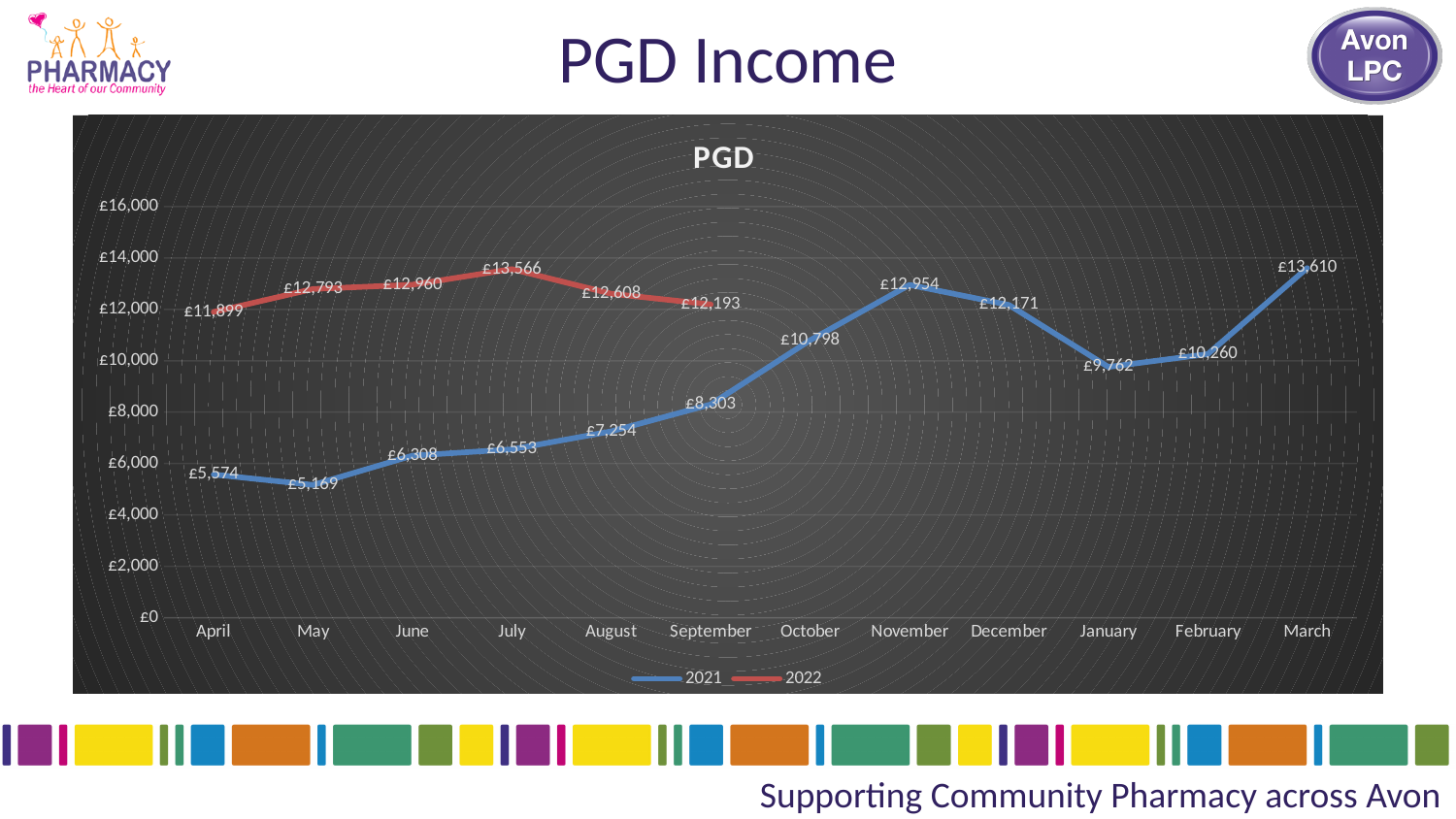
What kind of chart is this? Line chart Does the 2021 line rise or fall from April to September? Rise Which month has the highest 2021 value? March What is the 2022 value for July? £13,566 How many series does the legend list? 2 What is the 2021 value for November? £12,954 Which is larger in June, the 2021 value or the 2022 value? 2022 What is the difference between the 2022 and 2021 values for April? £6,325 Which month has the lowest 2021 value? May How many months are shown on the x axis? 12 What is the 2021 value for April? £5,574 Which month has the highest 2022 value? July